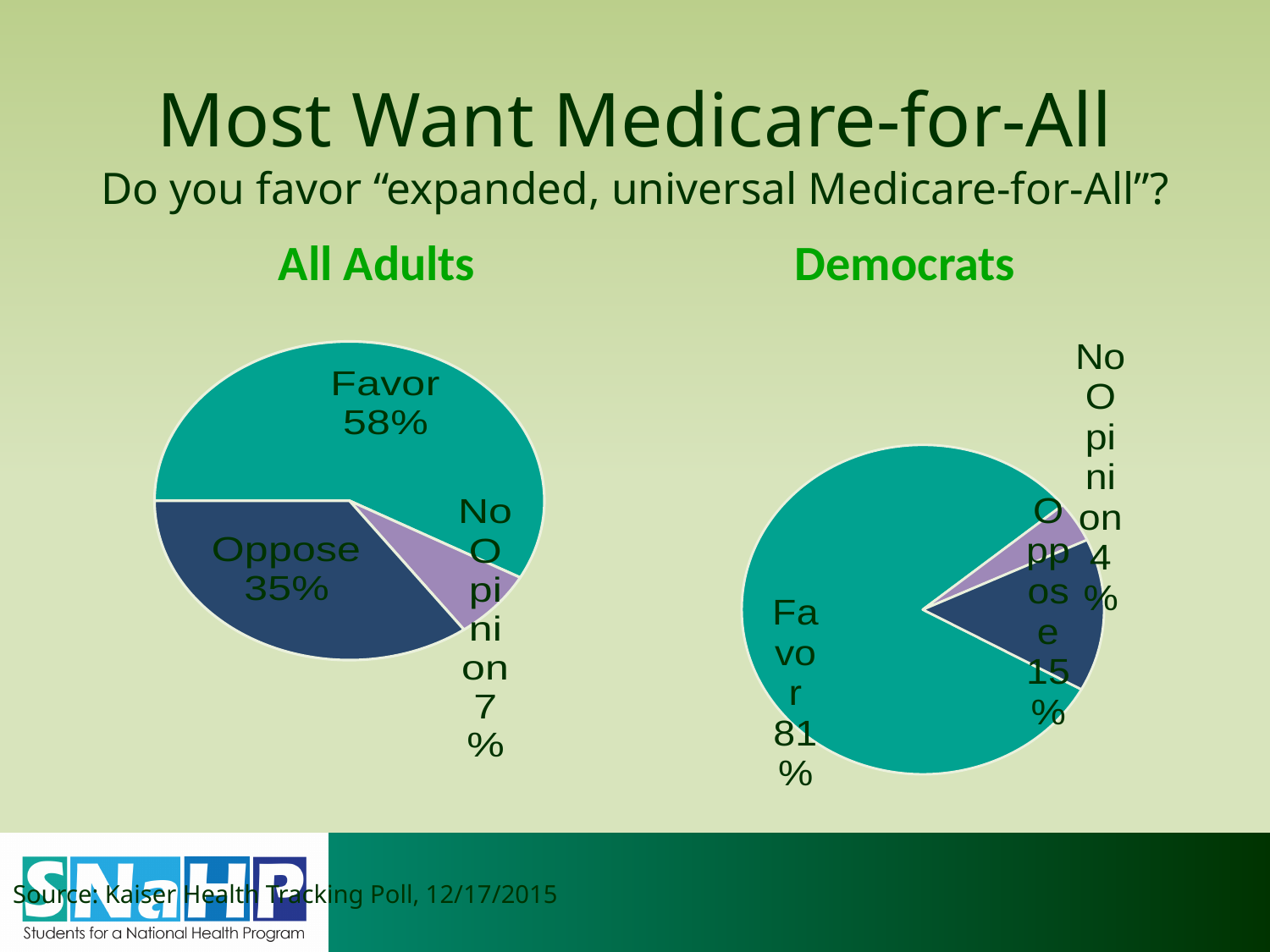
In the All Adults pie chart, what percentage of respondents oppose Medicare-for-All? 35% Which group has a larger Oppose share, All Adults or Democrats? All Adults In the All Adults pie chart, which response has the largest share? Favor In the All Adults pie chart, what percentage of respondents have no opinion? 7% What type of chart is used to show the All Adults results? Pie chart In the Democrats pie chart, what percentage of respondents oppose Medicare-for-All? 15% In the Democrats pie chart, what percentage of respondents have no opinion? 4% In the All Adults pie chart, what percentage of respondents favor Medicare-for-All? 58% In the All Adults pie chart, what is the difference between the Favor and Oppose shares? 23 percentage points What is the difference between the Favor share in the Democrats chart and the Favor share in the All Adults chart? 23 percentage points In the Democrats pie chart, what percentage of respondents favor Medicare-for-All? 81% In the Democrats pie chart, which response has the smallest share? No Opinion